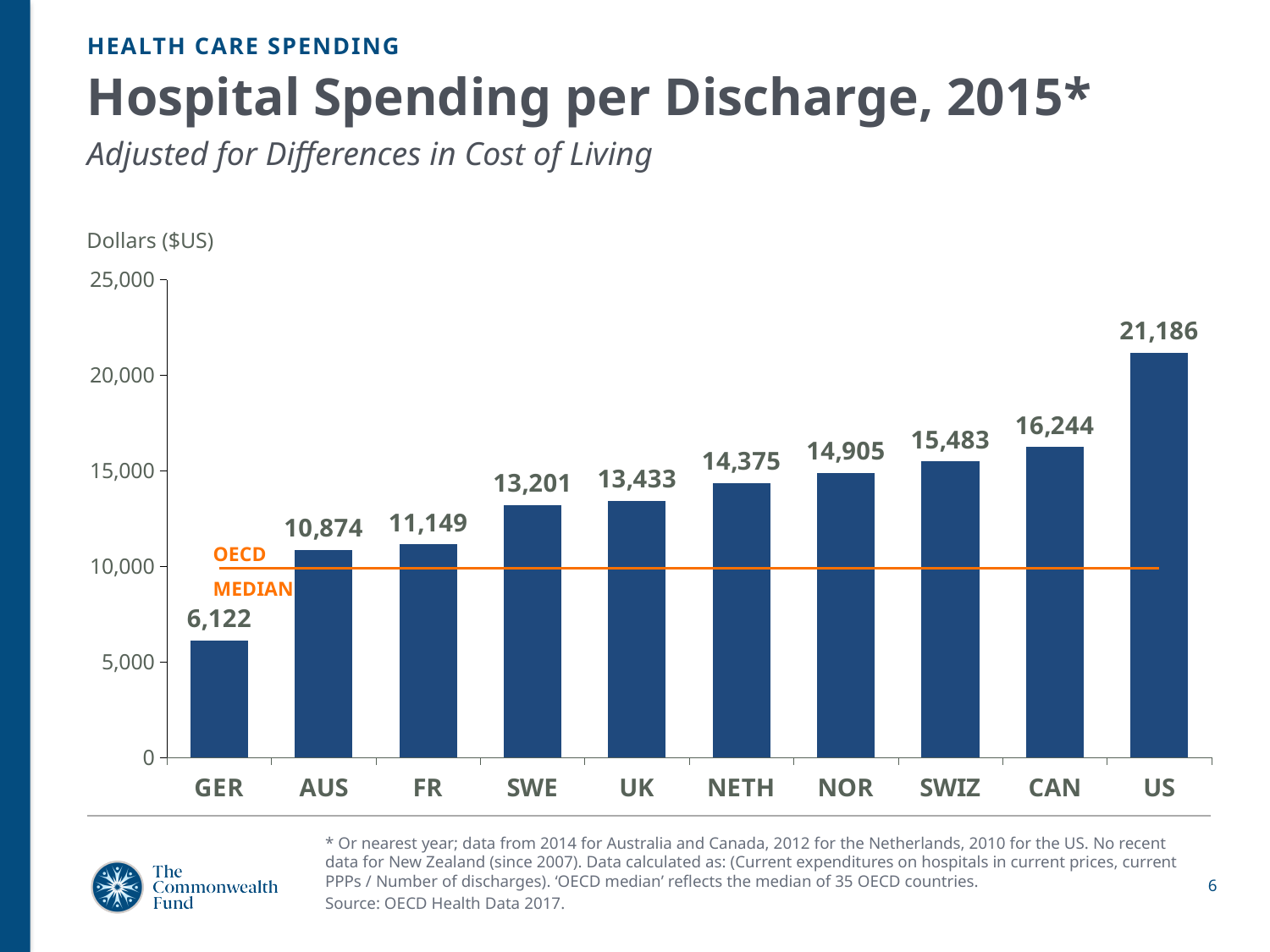
What does the orange horizontal line on the chart represent? OECD median Which country has the highest hospital spending per discharge? US How many countries are shown in the chart? 10 What is the difference between the values for Sweden (SWE) and Australia (AUS)? 2,327 What type of chart is used on this slide? bar chart What is the hospital spending per discharge for Germany (GER)? 6,122 Which country has the lowest hospital spending per discharge? GER What is the difference between the US and Canada (CAN) values? 4,942 What is the hospital spending per discharge for the US? 21,186 Which is larger, the value for Norway (NOR) or the Netherlands (NETH)? NOR What is the value shown for the UK? 13,433 Is the value for Germany (GER) greater or less than the OECD median line at about 10,000? less